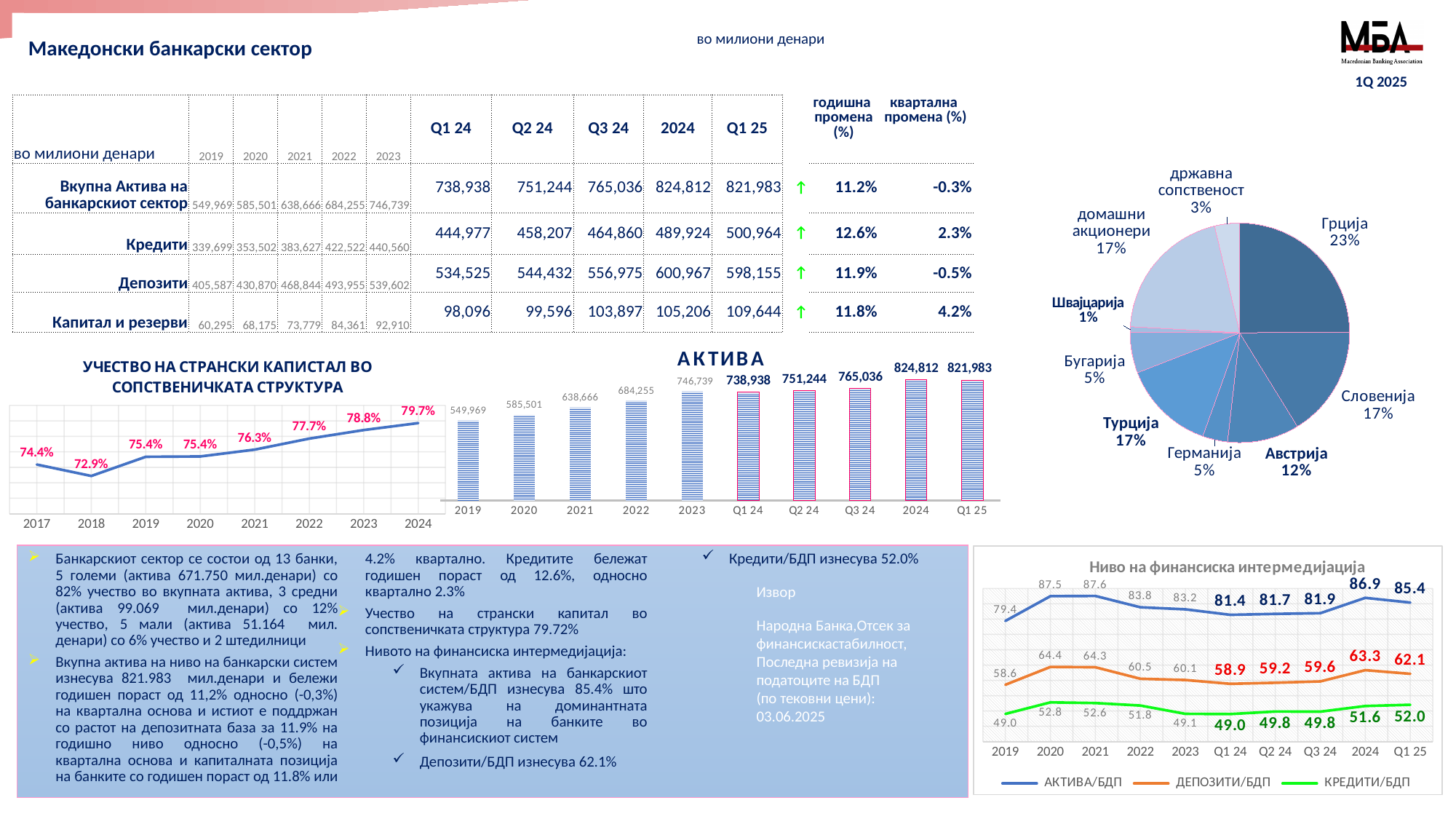
In the АКТИВА bar chart, what is the difference between the values for 2024 and Q1 25? 2,829 In the pie chart on the right, which slice is the largest? Грција How many series does the legend of the chart Ниво на финансиска интермедијација list? 3 In the pie chart on the right, what share does Грција have? 23% In the АКТИВА bar chart, which period has the highest value? 2024 How many bars are shown in the АКТИВА chart? 10 In the АКТИВА bar chart, which period has the lowest value? 2019 In the chart УЧЕСТВО НА СТРАНСКИ КАПИСТАЛ ВО СОПСТВЕНИЧКАТА СТРУКТУРА, what is the value for 2024? 79.7% What kind of chart is the АКТИВА chart? bar chart In the АКТИВА bar chart, what is the value for Q1 25? 821,983 In the chart УЧЕСТВО НА СТРАНСКИ КАПИСТАЛ ВО СОПСТВЕНИЧКАТА СТРУКТУРА, which year has the lowest value? 2018 In the pie chart on the right, which is larger, Турција or Австрија? Турција